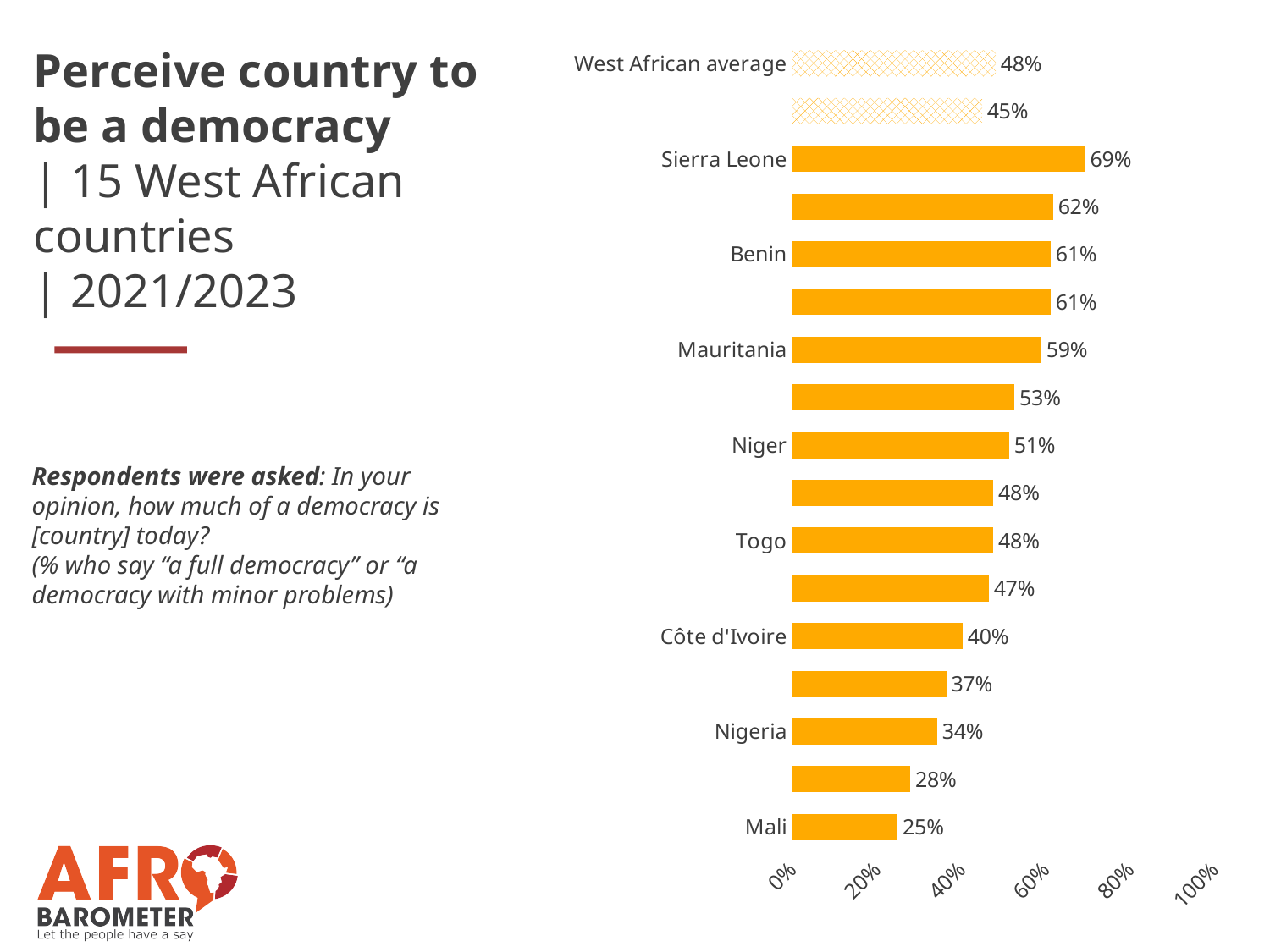
What is the difference in percentage points between Sierra Leone and Mali? 44 Do the country values increase or decrease going from the top of the chart to the bottom? Decrease Which has a higher value, Mauritania or Niger? Mauritania What percentage of respondents in Sierra Leone perceive their country to be a democracy? 69% What is the value shown for Togo? 48% Is the value for Nigeria greater or less than 40%? less What is the value shown for Mali? 25% Which labelled country has the highest percentage perceiving their country to be a democracy? Sierra Leone What is the difference in percentage points between Benin and Togo? 13 What is the value shown for the first West African average bar at the top of the chart? 48% Which labelled country has the lowest percentage? Mali What type of chart is shown on the slide? Bar chart